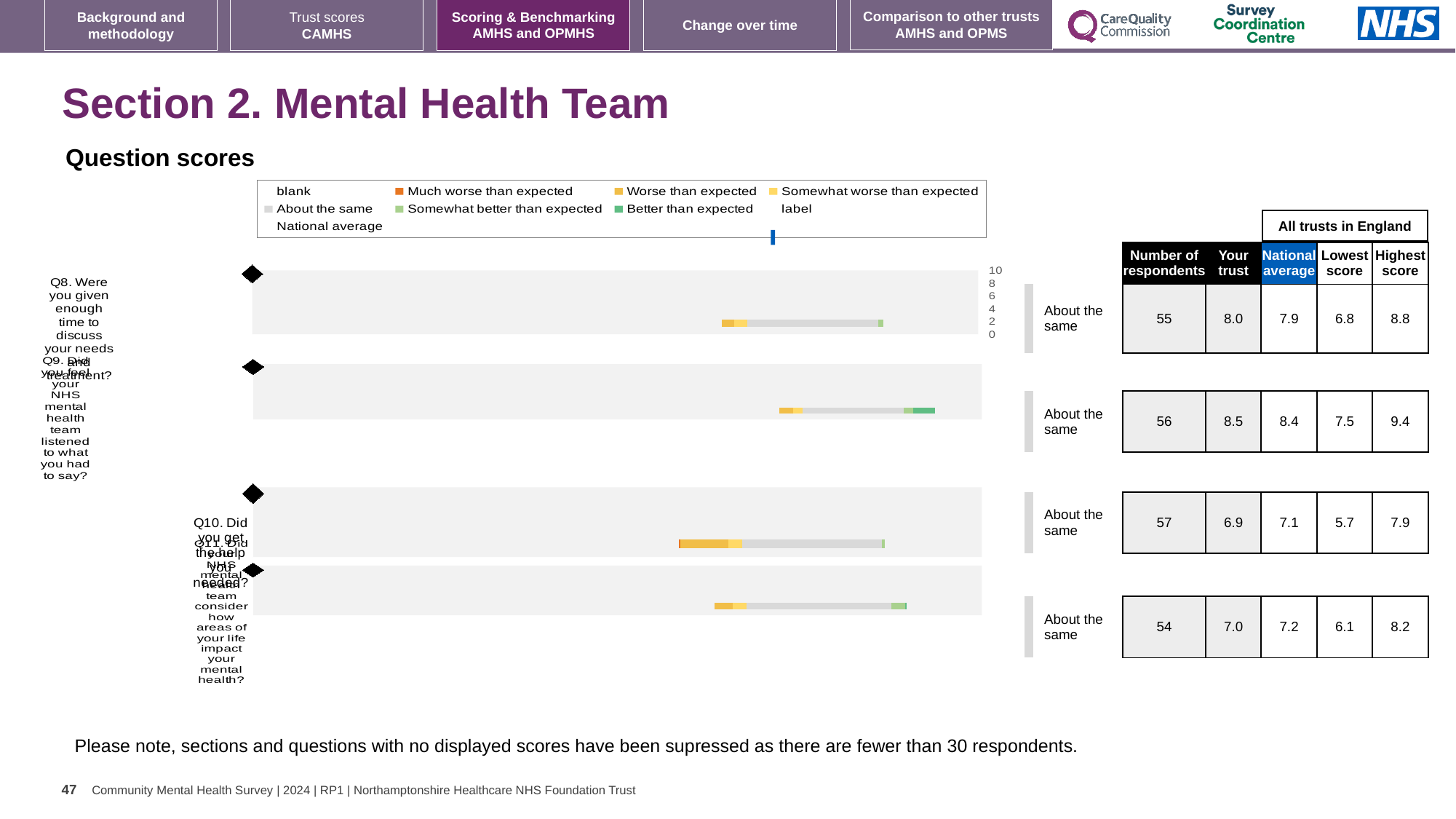
Which question has the lowest "Your trust" score in the table beside the chart? Q10 What kind of chart is shown under the heading "Question scores"? bar chart In the table beside the chart, what is the number of respondents for Q8? 55 What is the heading printed above the chart? Question scores Which question has the highest "Your trust" score in the table beside the chart? Q9 How many questions (bars) are plotted in the Question scores chart? 4 In the table beside the chart, what is the "Your trust" score for Q9? 8.5 For Q10, which is larger: the "Your trust" score or the national average? national average For Q9, what is the difference between the "Your trust" score and the national average? 0.1 In the table beside the chart, what is the highest score across all trusts in England for Q11? 8.2 What benchmark category label is shown next to the bar for Q8? About the same In the chart legend, what colour is used for "Better than expected"? green